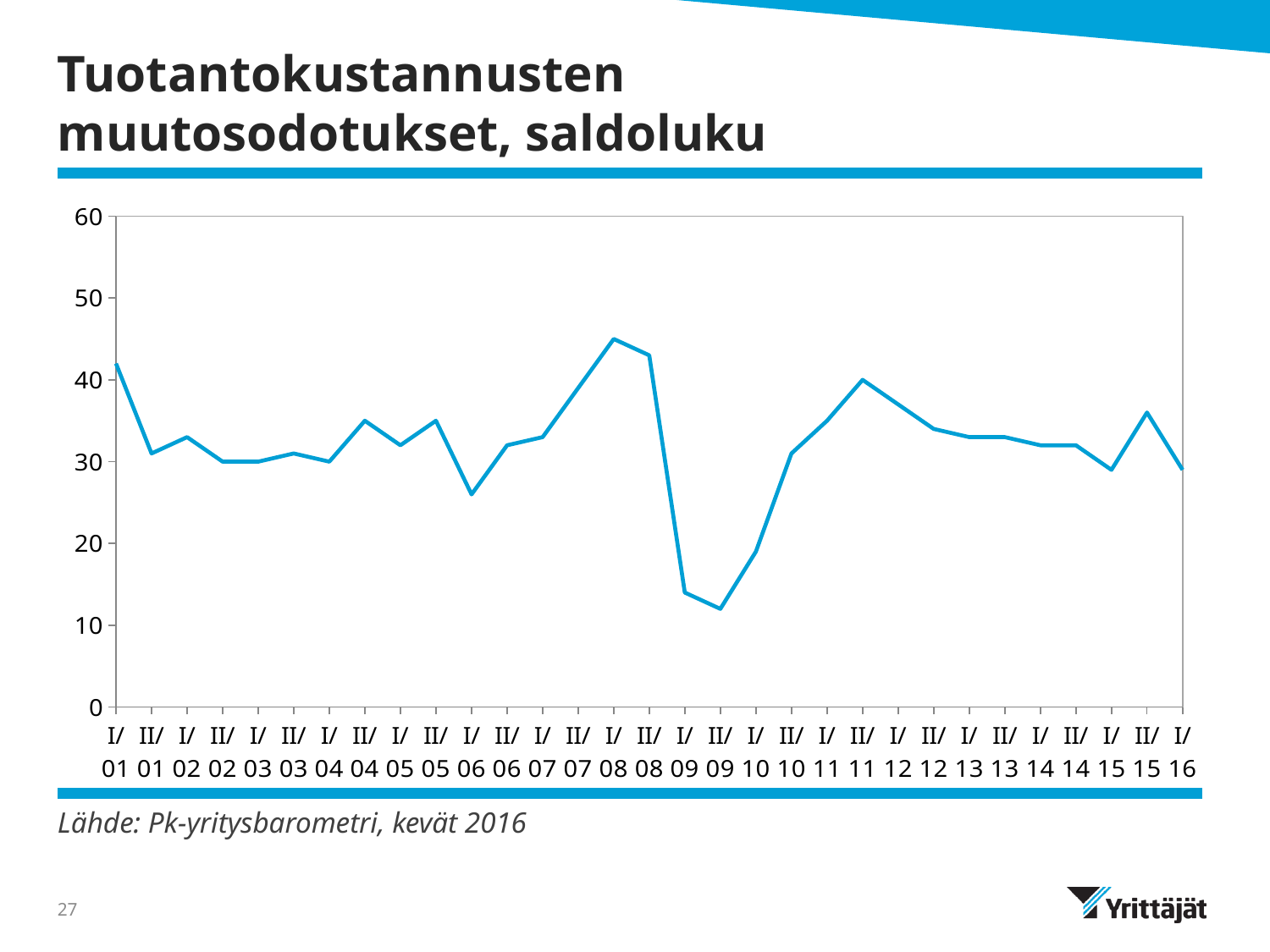
Is the value for I/01 greater or less than 40? greater Is the value for II/09 greater or less than 20? less Is the value for I/06 greater or less than 30? less Which period has the lowest value? II/09 What is the title of the chart? Tuotantokustannusten muutosodotukset, saldoluku Which period has the highest value? I/08 Do the values rise or fall from I/08 to II/09? fall Which is larger, the value for I/08 or the value for I/09? I/08 What kind of chart is shown on the slide? line chart What is the source given below the chart? Pk-yritysbarometri, kevät 2016 How many data points are plotted on the line? 31